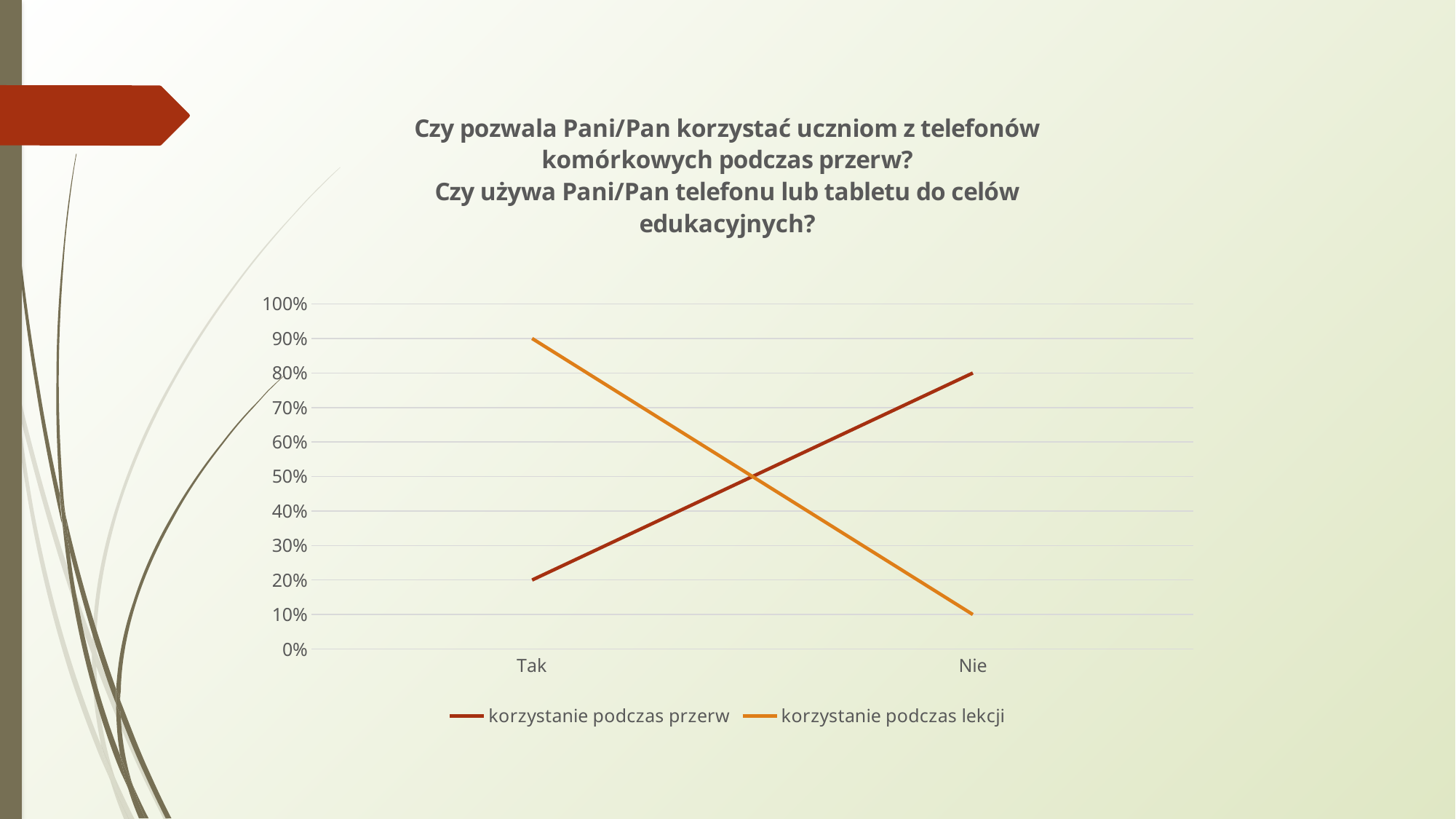
How many series does the legend list? 2 Does the "korzystanie podczas lekcji" line rise or fall from "Tak" to "Nie"? fall Which series has the higher value for "Tak"? korzystanie podczas lekcji How many categories are shown on the x axis? 2 What colour is the line for "korzystanie podczas lekcji"? orange Does the "korzystanie podczas przerw" line rise or fall from "Tak" to "Nie"? rise What is the value for "Tak" in the "korzystanie podczas lekcji" series? 90% What is the value for "Nie" in the "korzystanie podczas lekcji" series? 10% What is the difference between the "Tak" and "Nie" values in the "korzystanie podczas lekcji" series? 80% What is the value for "Nie" in the "korzystanie podczas przerw" series? 80% What kind of chart is shown on the slide? line chart What is the value for "Tak" in the "korzystanie podczas przerw" series? 20%